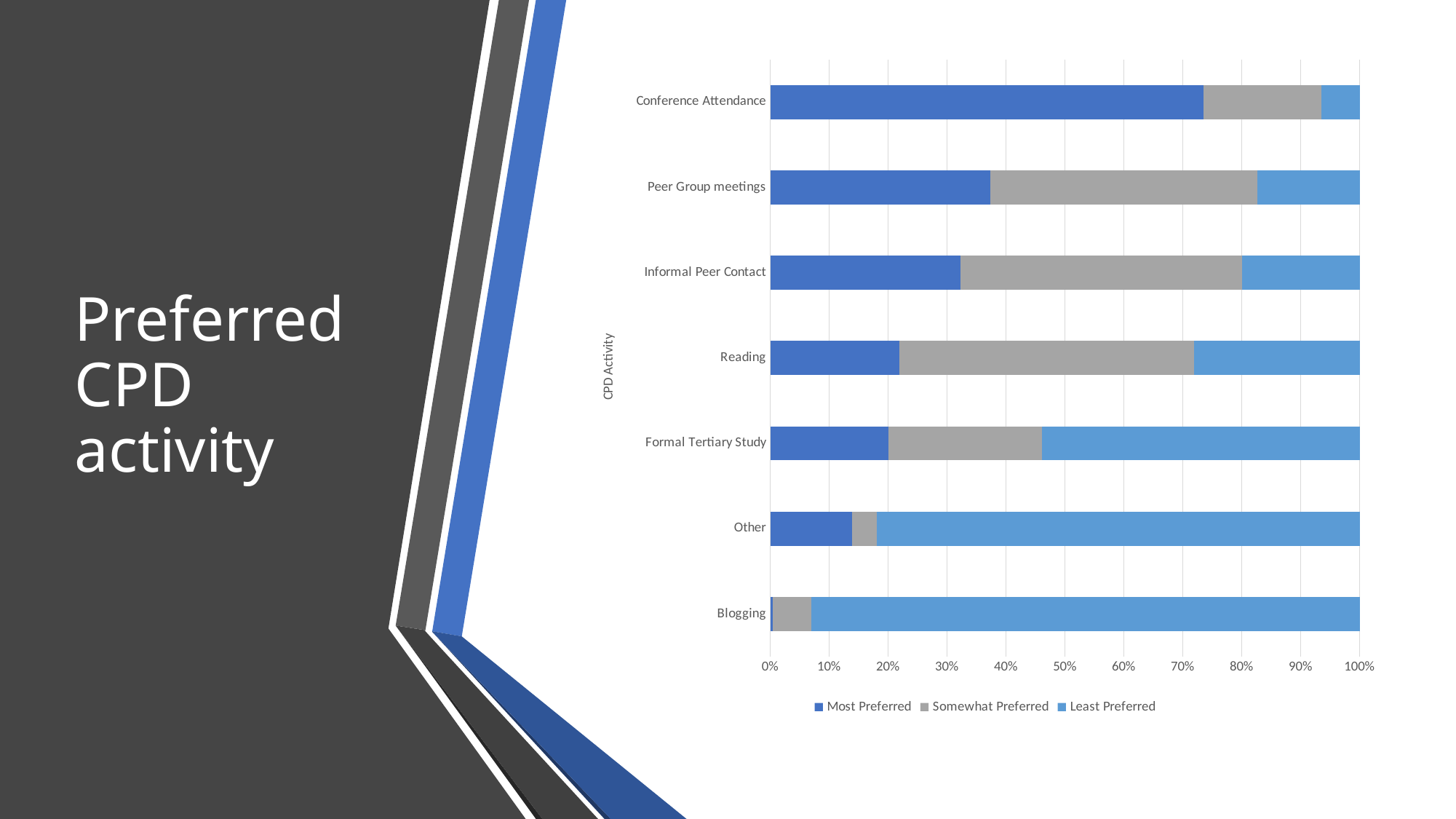
Which CPD activity has the largest Most Preferred share? Conference Attendance What kind of chart is shown on the slide? Stacked bar chart Which CPD activity has the largest Least Preferred share? Blogging Is the Least Preferred value for Other greater or less than 70%? greater Which CPD activity has the smallest Most Preferred share? Blogging What is the total of the stacked bar for Reading? 100% How many CPD activities are listed on the chart? 7 Which has a larger Most Preferred share, Peer Group meetings or Formal Tertiary Study? Peer Group meetings Is the Most Preferred value for Conference Attendance greater or less than 60%? greater How many series does the legend list? 3 Is the Most Preferred value for Reading greater or less than 30%? less What is the title of the vertical axis? CPD Activity